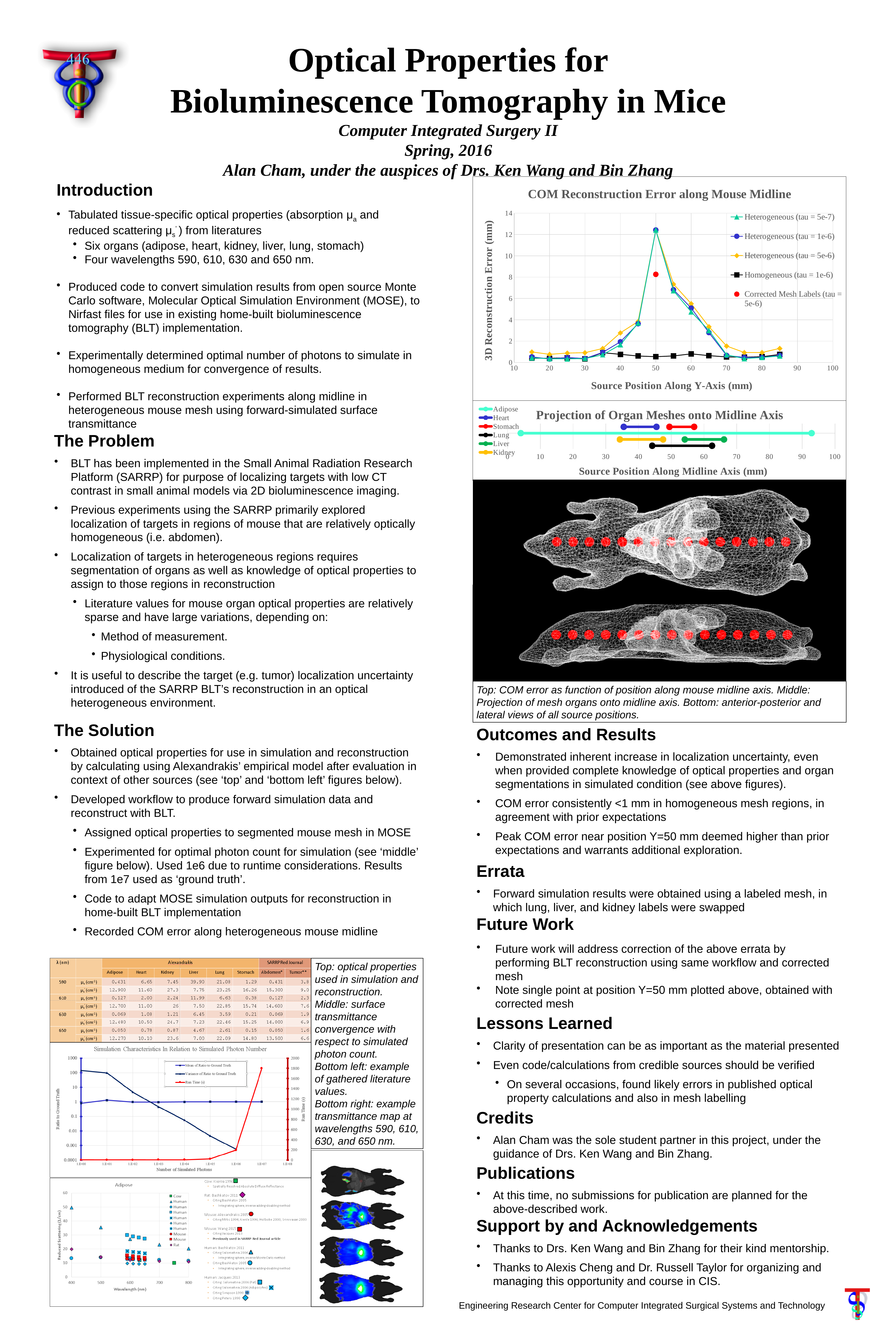
In the 'COM Reconstruction Error along Mouse Midline' chart, at source position 50, which series has the larger value: Heterogeneous (tau = 5e-7) or Homogeneous (tau = 1e-6)? Heterogeneous (tau = 5e-7) In the 'Simulation Characteristics In Relation to Simulated Photon Number' chart at the bottom left, does the Run Time series rise or fall as the number of simulated photons increases? rise In the 'COM Reconstruction Error along Mouse Midline' chart, is the value for Heterogeneous (tau = 5e-7) at source position 50 greater or less than 10? greater In the 'COM Reconstruction Error along Mouse Midline' chart, how many series does the legend list? 5 In the 'COM Reconstruction Error along Mouse Midline' chart, what kind of chart is shown? Line chart In the 'Projection of Organ Meshes onto Midline Axis' chart, how many organs are listed in the legend? 6 In the 'COM Reconstruction Error along Mouse Midline' chart, is the value for Corrected Mesh Labels (tau = 5e-6) at source position 50 greater or less than 6? greater In the 'COM Reconstruction Error along Mouse Midline' chart, what is the y-axis title? 3D Reconstruction Error (mm) In the 'COM Reconstruction Error along Mouse Midline' chart, what is the x-axis title? Source Position Along Y-Axis (mm) In the 'Simulation Characteristics In Relation to Simulated Photon Number' chart at the bottom left, how many series does the legend list? 3 In the 'COM Reconstruction Error along Mouse Midline' chart, at which source position does the Heterogeneous (tau = 5e-7) series reach its highest value? 50 In the 'COM Reconstruction Error along Mouse Midline' chart, is the value for Homogeneous (tau = 1e-6) at source position 50 greater or less than 2? less